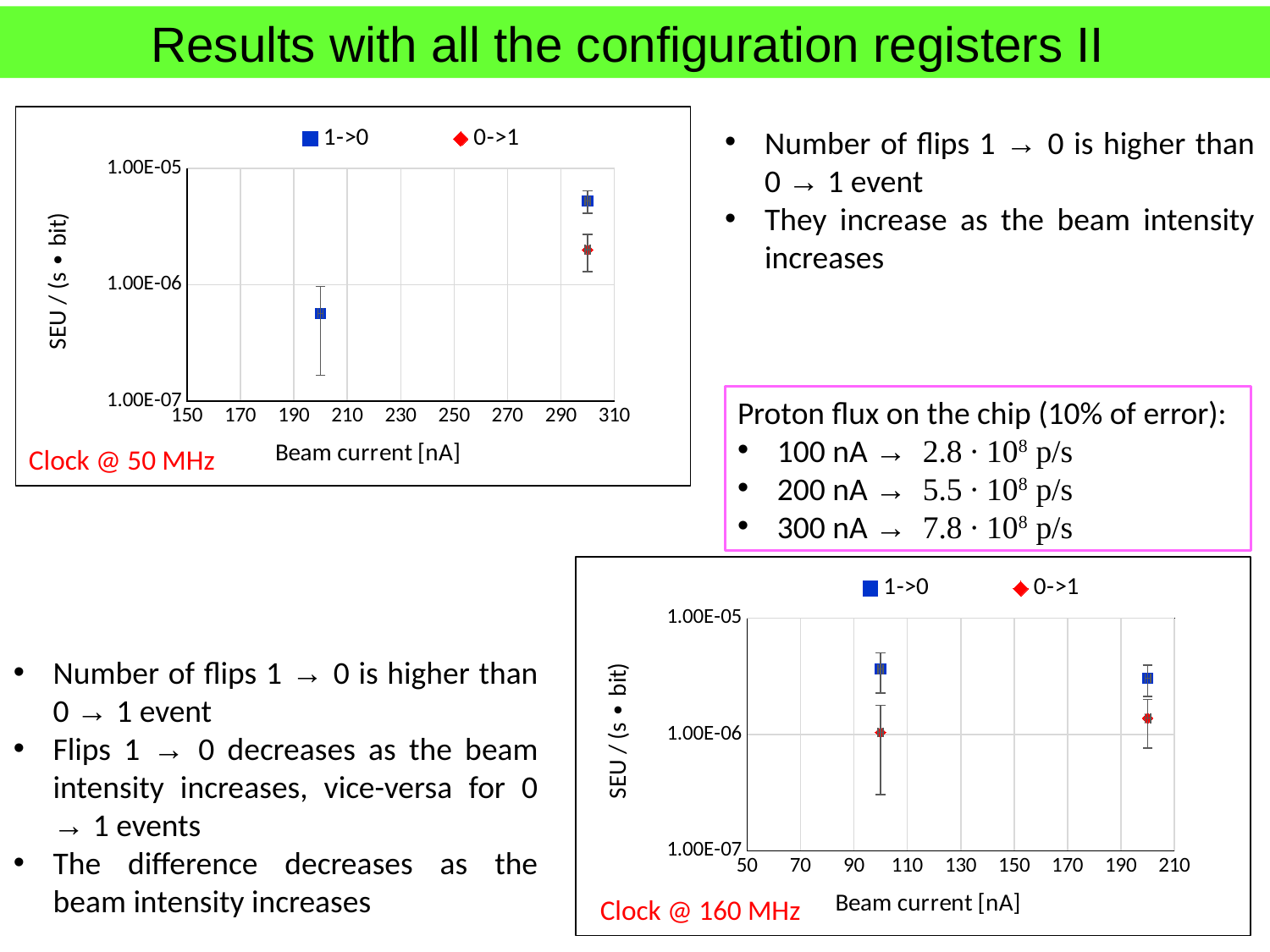
In the 'Clock @ 50 MHz' chart, which series has the larger value at 300 nA, 1->0 or 0->1? 1->0 What kind of chart is the 'Clock @ 50 MHz' chart? scatter chart In the 'Clock @ 160 MHz' chart, is the 1->0 value at 100 nA greater or less than 1.00E-06? greater In the 'Clock @ 160 MHz' chart, which series has the larger value at 100 nA, 1->0 or 0->1? 1->0 In the 'Clock @ 50 MHz' chart, does the 1->0 series rise or fall as beam current increases? rise In the 'Clock @ 50 MHz' chart, what is the x-axis title? Beam current [nA] How many series does the legend of the 'Clock @ 50 MHz' chart list? 2 In the 'Clock @ 50 MHz' chart, is the 0->1 value at 300 nA greater or less than 1.00E-06? greater In the 'Clock @ 50 MHz' chart, how many data points are plotted for the 1->0 series? 2 In the 'Clock @ 50 MHz' chart, is the 1->0 value at 300 nA greater or less than 1.00E-06? greater In the 'Clock @ 160 MHz' chart, what is the y-axis title? SEU / (s • bit)